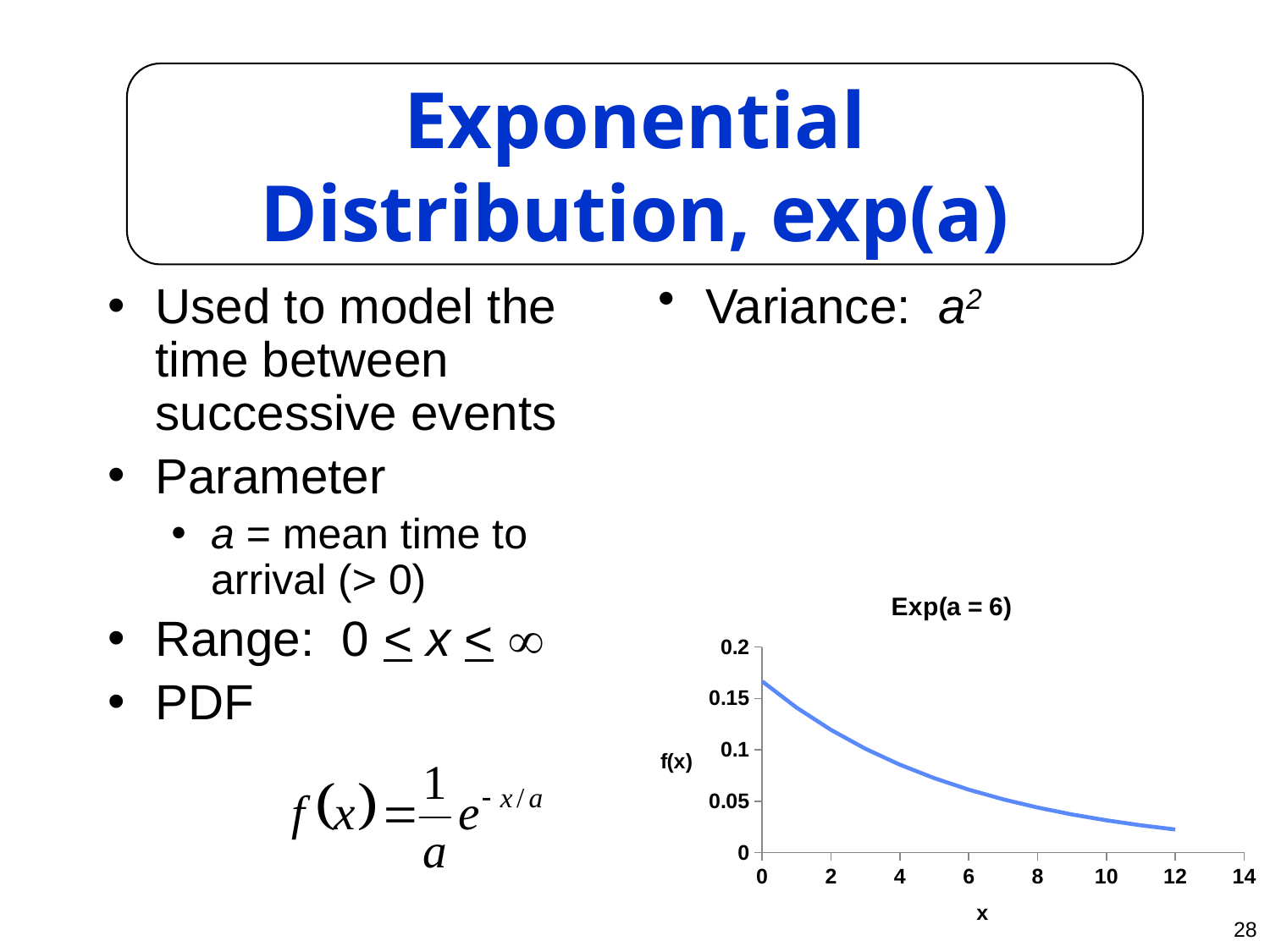
Is the value of f(x) at x = 6 greater or less than 0.1? less At which x value shown on the axis is f(x) highest? 0 Is the value of f(x) at x = 12 greater or less than 0.05? less Is the value of f(x) at x = 2 greater or less than 0.1? greater Do the values of f(x) rise or fall as x increases along the x axis? fall Which is larger, the value of f(x) at x = 2 or at x = 10? x = 2 What is the title of the chart? Exp(a = 6) What is the label of the vertical axis of the chart? f(x) What kind of chart is shown on the slide? line chart What is the highest tick value shown on the vertical axis? 0.2